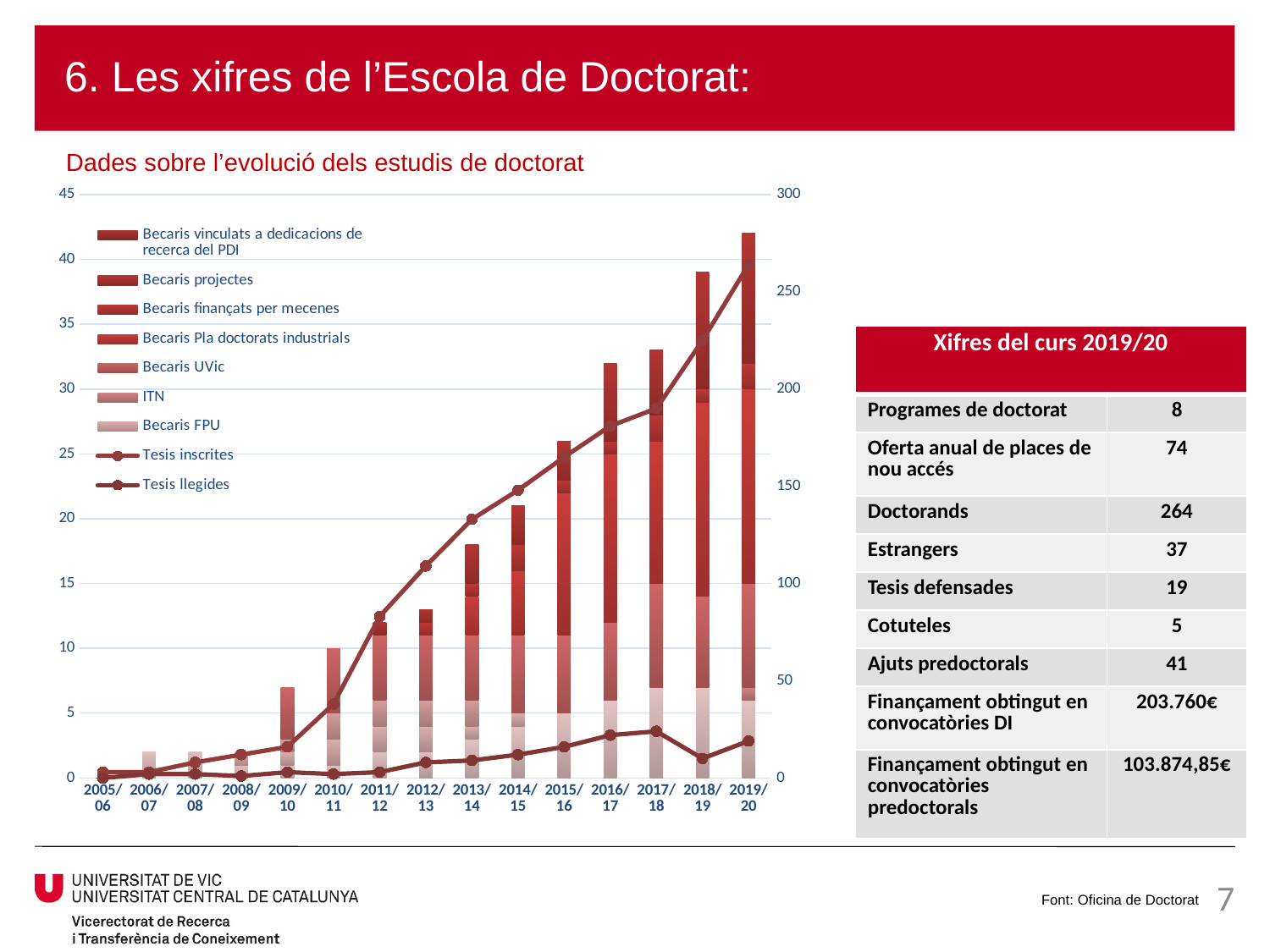
What is the title shown above the chart? Dades sobre l'evolució dels estudis de doctorat Is the value of the Tesis llegides line for 2019/20 greater or less than 50 on the right axis? less What kind of chart is shown on the slide? A combined stacked bar and line chart How many academic years are shown on the x axis of the chart? 15 Does the Tesis inscrites line generally rise or fall from 2005/06 to 2019/20? Rise Is the total height of the stacked bar for 2016/17 greater or less than 30 on the left axis? greater Is the value of the Tesis inscrites line for 2019/20 greater or less than 250 on the right axis? greater How many series does the chart legend list? 9 Which academic year has the smallest stacked bar in the chart? 2005/06 Which stacked bar is taller, 2019/20 or 2017/18? 2019/20 Which academic year has the tallest stacked bar in the chart? 2019/20